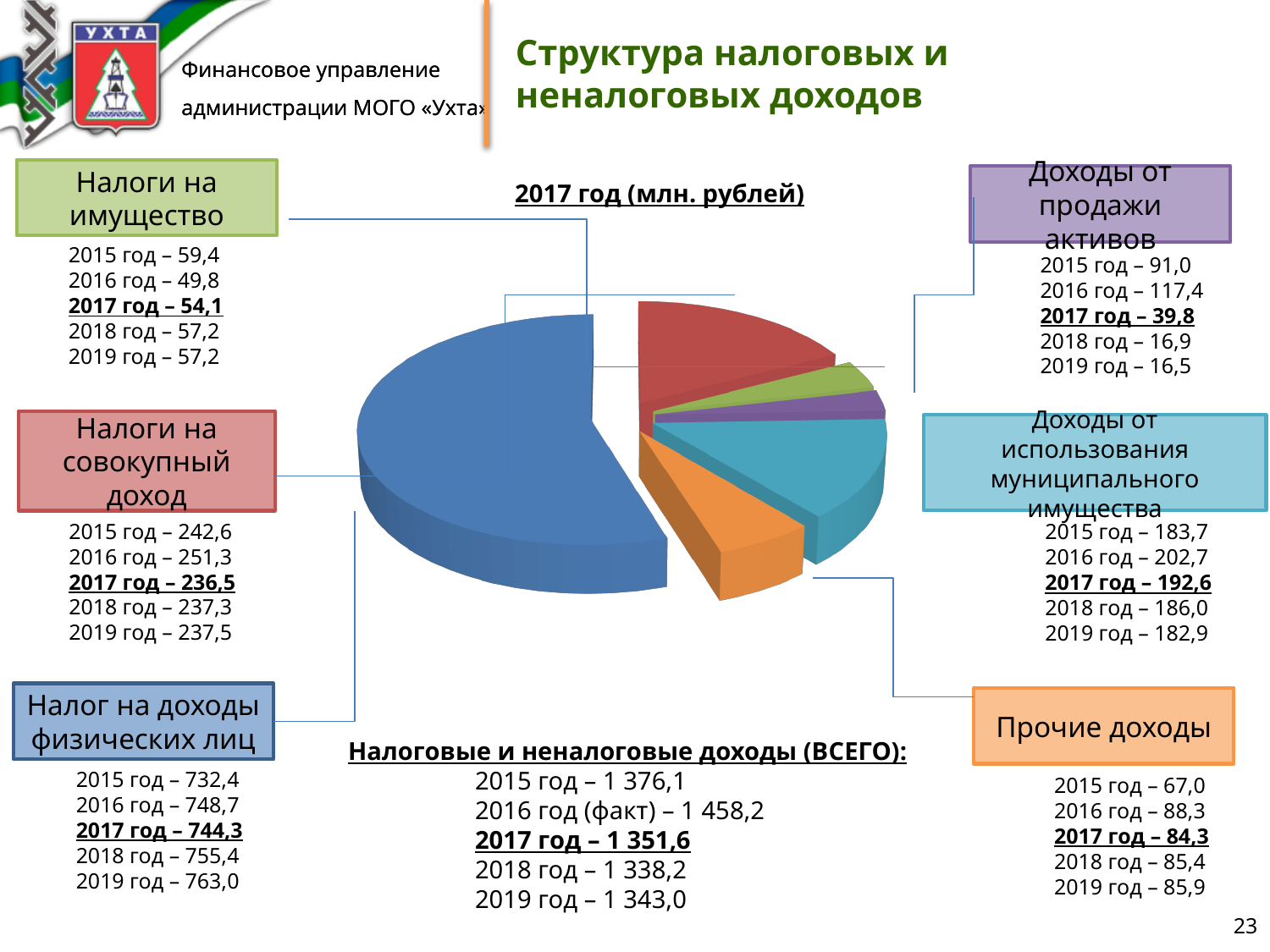
How many slices does the pie chart have? 6 What is the 2017 value for Налоги на имущество? 54,1 What is the 2017 value for Доходы от использования муниципального имущества? 192,6 What is the total of all tax and non-tax revenues for 2017 shown on the slide? 1 351,6 What is the title of the pie chart? 2017 год (млн. рублей) By how much does the 2017 value for Налоги на совокупный доход exceed that for Доходы от использования муниципального имущества? 43,9 What is the 2017 value for Доходы от продажи активов? 39,8 Which is larger in 2017: Прочие доходы or Налоги на имущество? Прочие доходы Which category has the smallest slice in the pie chart? Доходы от продажи активов Which category has the largest slice in the pie chart? Налог на доходы физических лиц What is the 2017 value for Прочие доходы? 84,3 What kind of chart is shown on the slide? pie chart